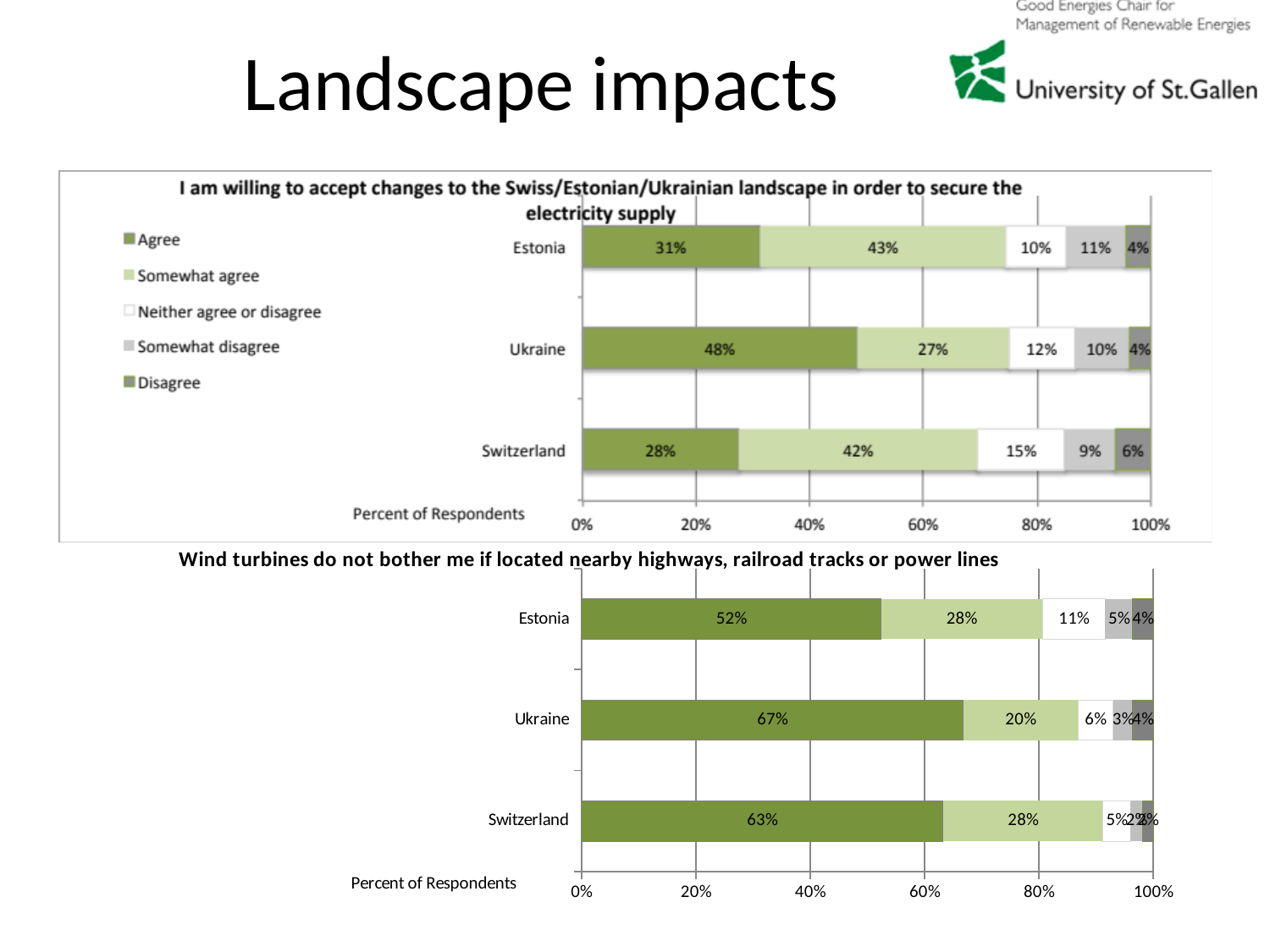
In the bottom chart about wind turbines near highways, railroad tracks or power lines, is the first (dark green) segment for Estonia larger or smaller than that for Switzerland? Smaller In the top chart about accepting changes to the landscape, what is the difference between the 'Agree' shares for Ukraine and Estonia? 17% How many countries are shown in the bottom chart about wind turbines near highways, railroad tracks or power lines? 3 In the top chart about accepting changes to the landscape, what percentage of Estonian respondents chose 'Somewhat agree'? 43% How many series does the legend of the top chart about accepting changes to the landscape list? 5 In the top chart about accepting changes to the landscape, which country has the lowest 'Agree' share? Switzerland In the bottom chart titled 'Wind turbines do not bother me if located nearby highways, railroad tracks or power lines', what is the value of the first (dark green) segment for Ukraine? 67% In the chart titled 'I am willing to accept changes to the Swiss/Estonian/Ukrainian landscape in order to secure the electricity supply', what percentage of Ukrainian respondents chose 'Agree'? 48% What kind of chart is the chart titled 'Wind turbines do not bother me if located nearby highways, railroad tracks or power lines'? Stacked bar chart In the bottom chart about wind turbines near highways, railroad tracks or power lines, which country has the largest first (dark green) segment? Ukraine In the top chart about accepting changes to the landscape, what percentage of Swiss respondents chose 'Neither agree or disagree'? 15% In the top chart about accepting changes to the landscape, which country has the highest 'Agree' share? Ukraine